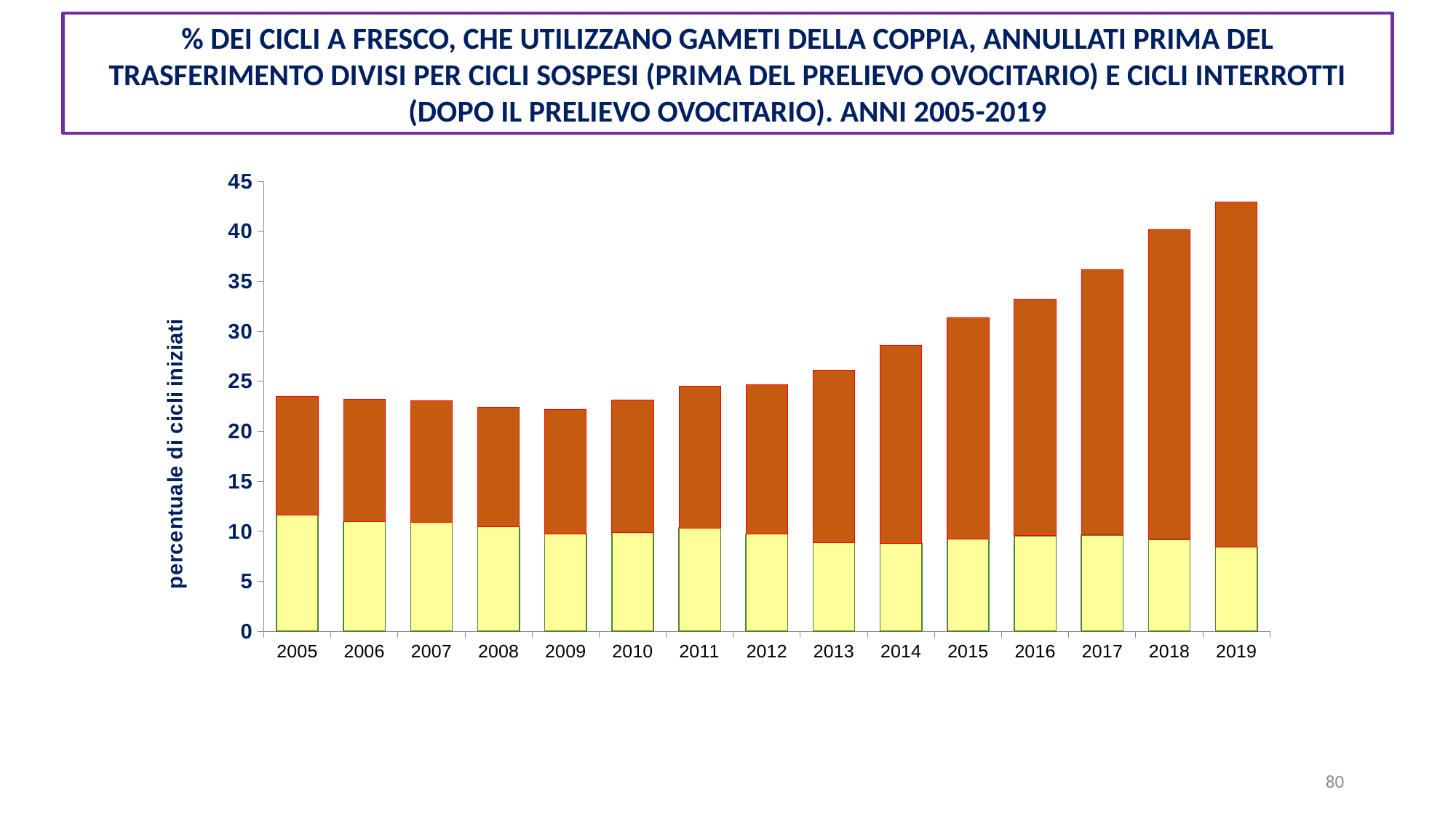
Do the total bar heights generally rise or fall from 2010 to 2019? rise Is the total bar for 2014 greater or less than 30? less Is the total bar for 2019 greater or less than 40? greater What is the label on the vertical axis of the chart? percentuale di cicli iniziati Is the total bar for 2017 greater or less than 35? greater How many years are shown along the x axis of the chart? 15 Which year has the larger total bar, 2013 or 2016? 2016 What kind of chart is shown on the slide? stacked bar chart Which year has the highest total bar in the chart? 2019